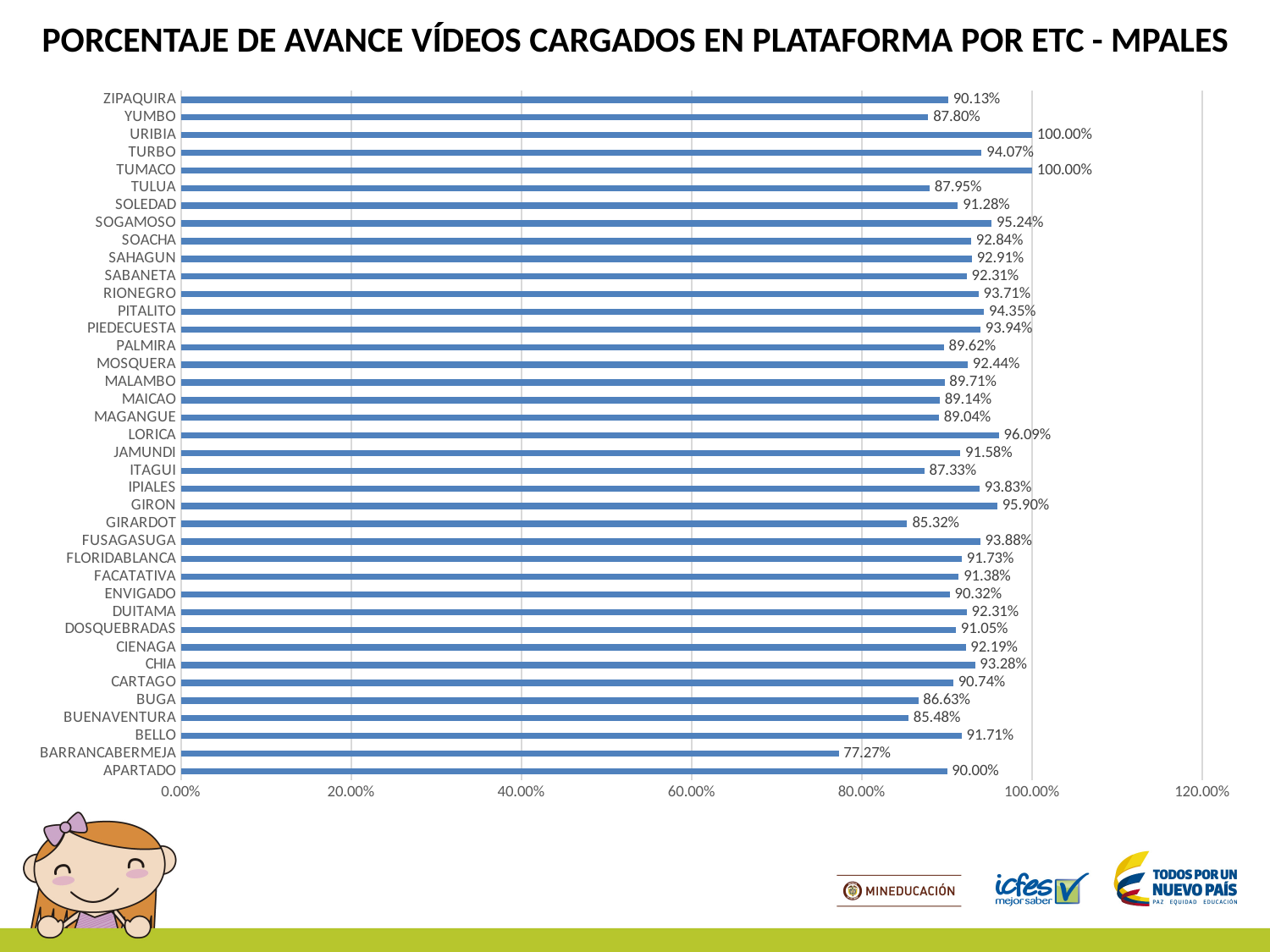
Which municipality has the lowest value? BARRANCABERMEJA Is the value for BUENAVENTURA greater or less than 80.00%? greater What is the value for BARRANCABERMEJA? 77.27% How many municipalities are shown in the chart? 39 What is the value for GIRARDOT? 85.32% What is the difference between the values for GIRON and GIRARDOT? 10.58% What is the difference between the values for URIBIA and BARRANCABERMEJA? 22.73% What kind of chart is shown on the slide? bar chart What is the value for APARTADO? 90.00% Which has a larger value, SOGAMOSO or SOACHA? SOGAMOSO What is the title of the chart? PORCENTAJE DE AVANCE VÍDEOS CARGADOS EN PLATAFORMA POR ETC - MPALES What is the value for LORICA? 96.09%